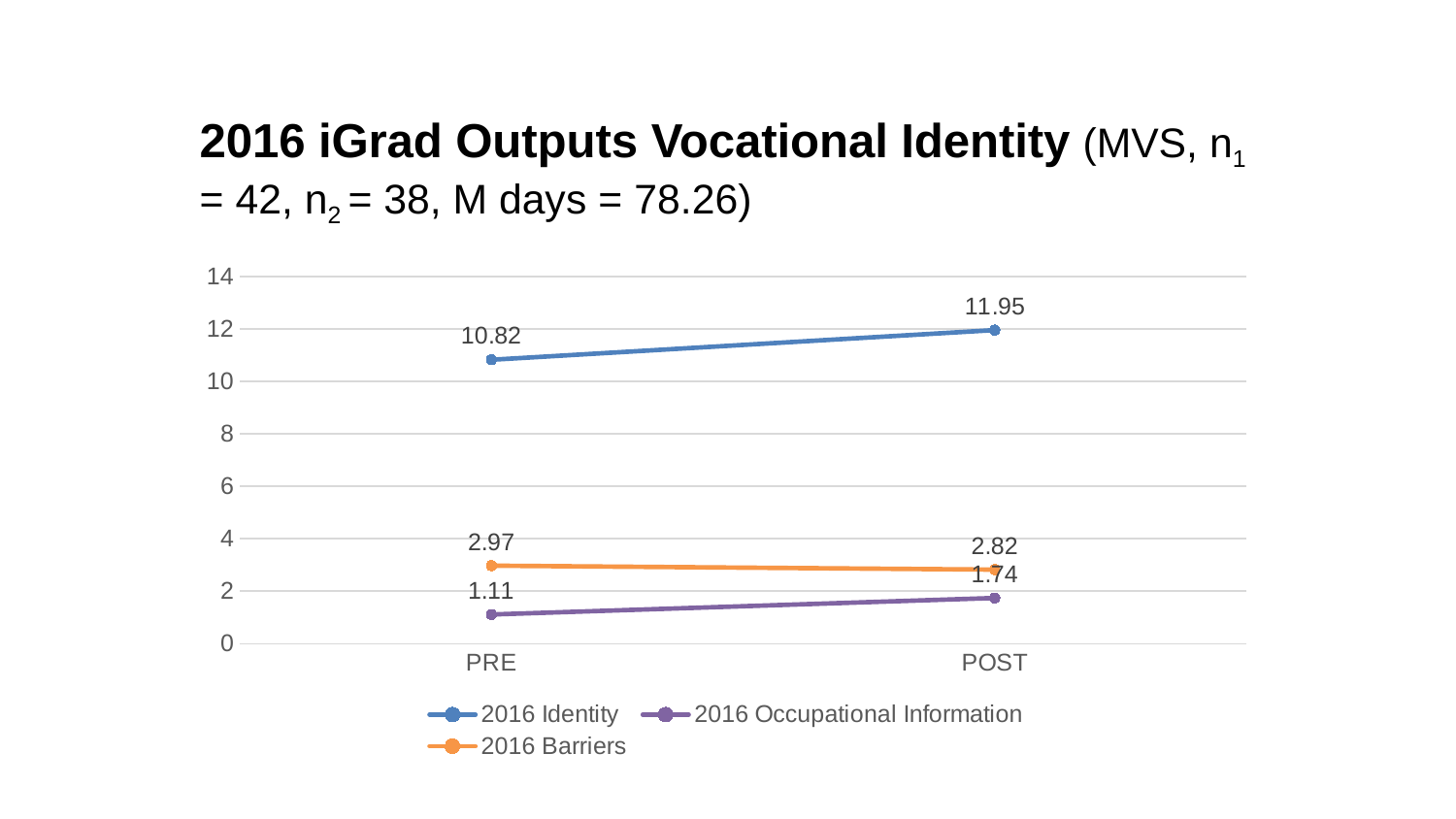
What is the value for 2016 Identity at POST? 11.95 What kind of chart is shown on the slide? line chart Which is larger, the 2016 Barriers value at PRE or at POST? PRE Which series has the highest value at POST? 2016 Identity What is the value for 2016 Occupational Information at POST? 1.74 What is the value for 2016 Identity at PRE? 10.82 What is the difference between the 2016 Identity values at POST and PRE? 1.13 How many categories are on the x axis? 2 How many series does the legend list? 3 Which series has the lowest value at PRE? 2016 Occupational Information Does the 2016 Occupational Information series rise or fall from PRE to POST? rise What is the value for 2016 Barriers at PRE? 2.97